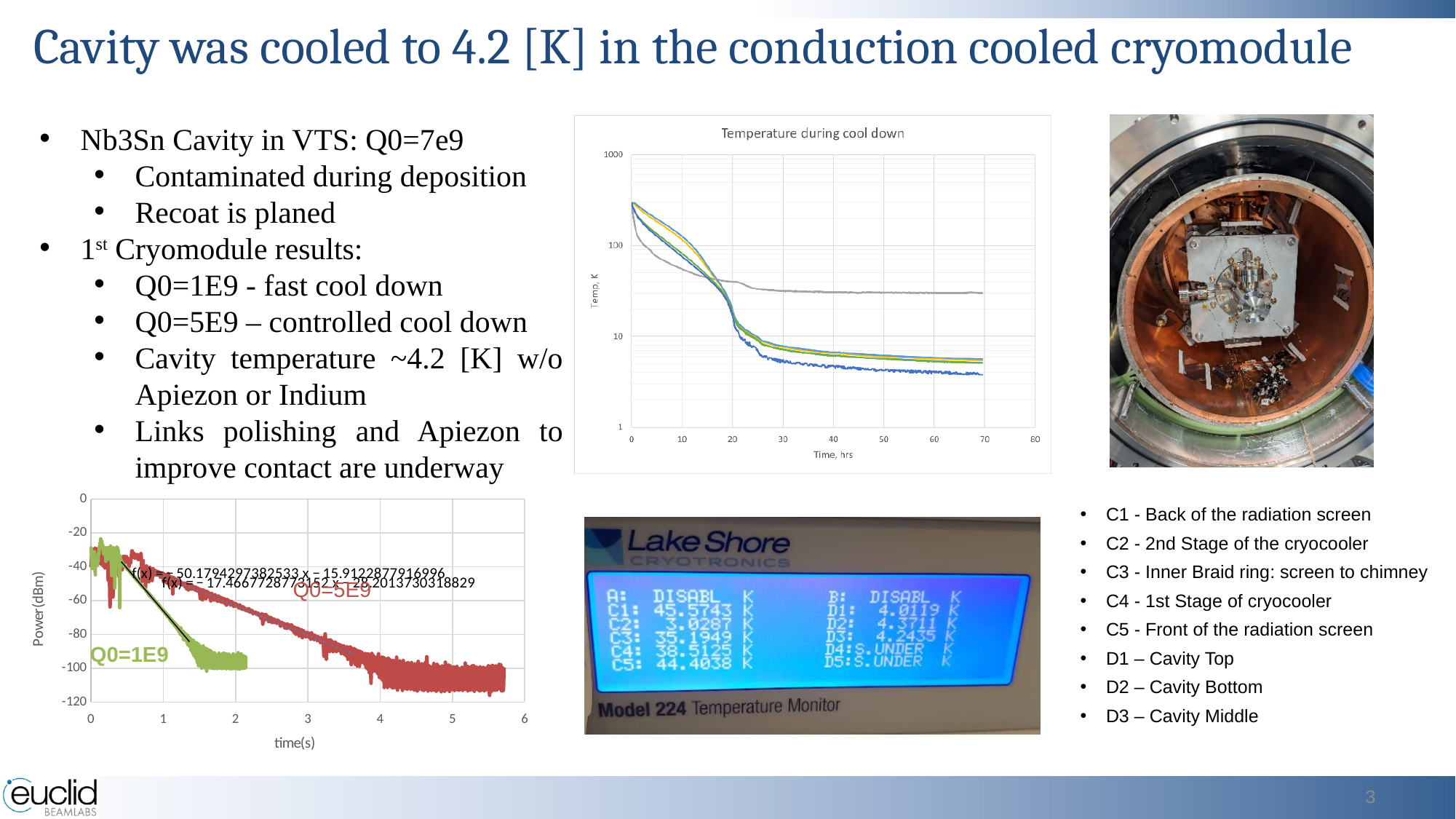
In the Power (dBm) versus time(s) chart, what colour is the Q0=1E9 series? green In the Power (dBm) versus time(s) chart, how many series are labelled? 2 What kind of chart is the Power (dBm) versus time(s) chart at the bottom left of the slide? line chart What is the title of the chart in the top centre of the slide? Temperature during cool down In the Power (dBm) versus time(s) chart, is the value of the Q0=5E9 series at 5 seconds greater or less than -80? less In the 'Temperature during cool down' chart, do the temperature values rise or fall as time increases? fall In the Power (dBm) versus time(s) chart, which series extends to a later time, Q0=1E9 or Q0=5E9? Q0=5E9 What kind of chart is the 'Temperature during cool down' chart? line chart In the 'Temperature during cool down' chart, is the value of the grey line at 70 hours greater or less than 10? greater In the 'Temperature during cool down' chart, is the value of the blue line at 70 hours greater or less than 10? less How many lines are plotted in the 'Temperature during cool down' chart? 4